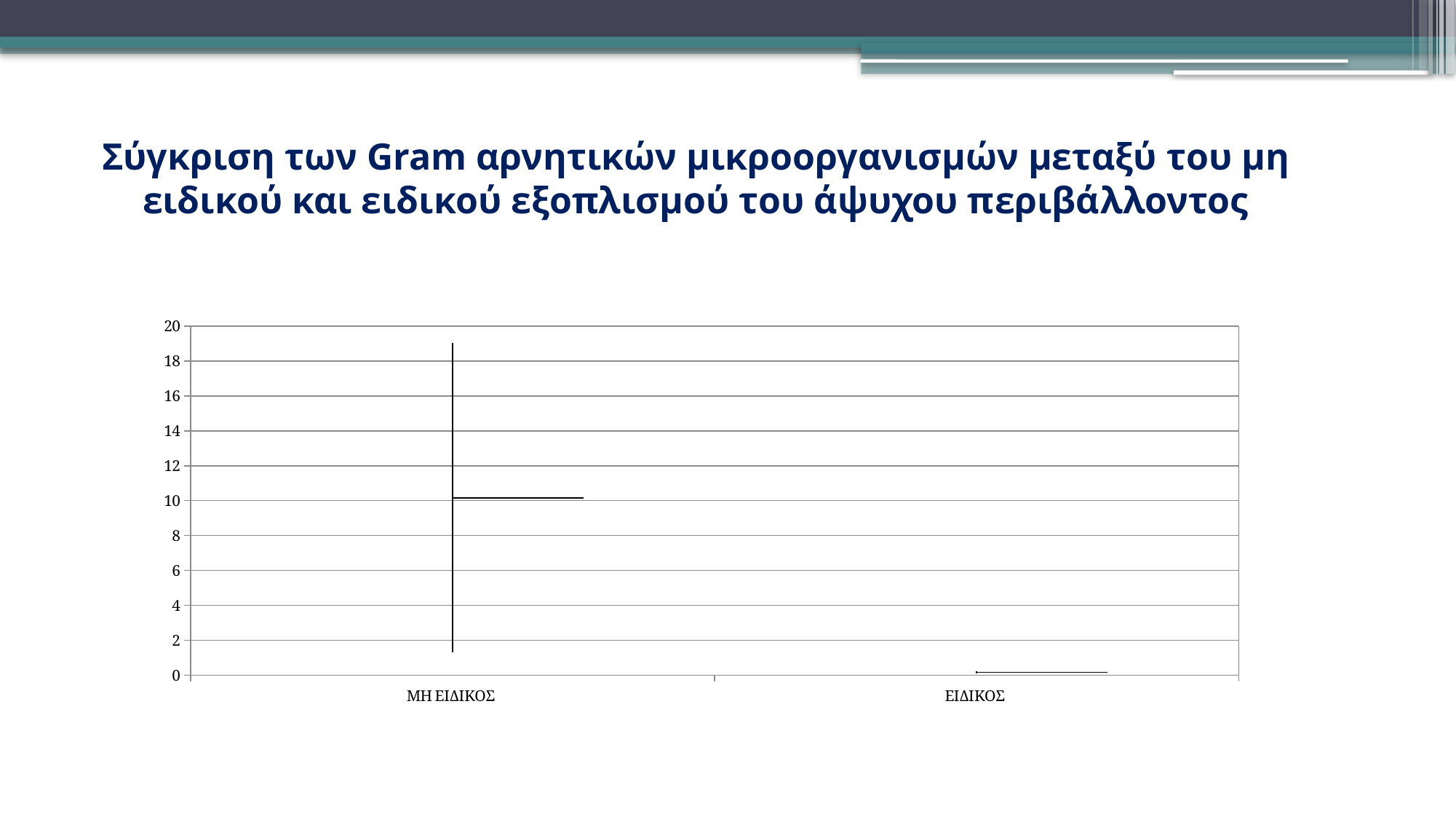
Is the value for ΕΙΔΙΚΟΣ greater or less than 4? less Do the values rise or fall from ΜΗ ΕΙΔΙΚΟΣ to ΕΙΔΙΚΟΣ? fall Which category has the higher value, ΜΗ ΕΙΔΙΚΟΣ or ΕΙΔΙΚΟΣ? ΜΗ ΕΙΔΙΚΟΣ What is the maximum value shown on the y axis? 20 Which category has the lowest value? ΕΙΔΙΚΟΣ Is the value for ΕΙΔΙΚΟΣ greater or less than 2? less How many categories are shown on the x axis? 2 What is the label of the first category on the x axis? ΜΗ ΕΙΔΙΚΟΣ Which category has the highest value? ΜΗ ΕΙΔΙΚΟΣ